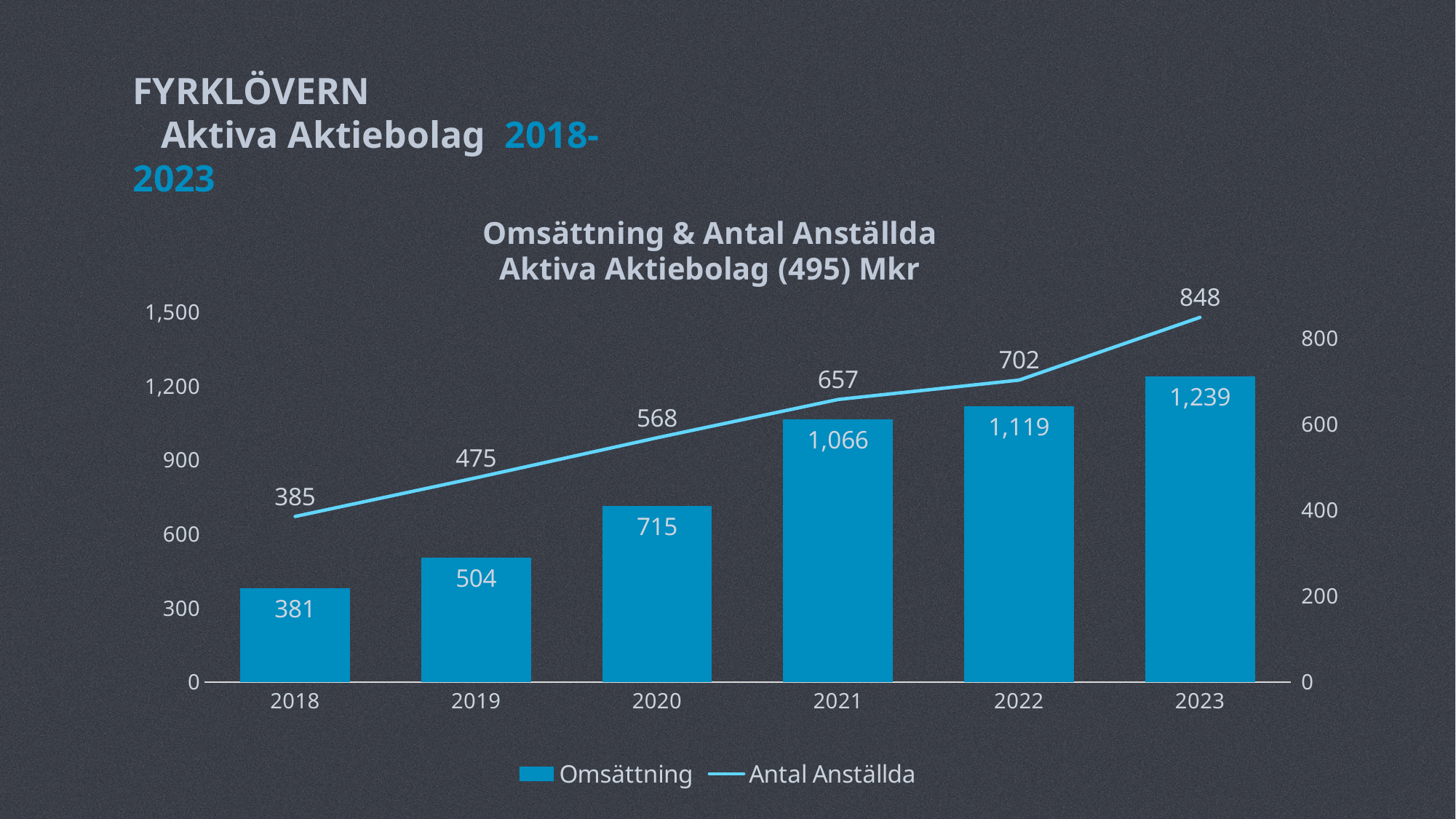
What is the difference in Omsättning between 2023 and 2022? 120 Does the Antal Anställda line rise or fall from 2018 to 2023? rise Which year has the lowest Antal Anställda? 2018 How many series does the legend list? 2 How many years are shown on the x axis? 6 What is the Omsättning value for 2018? 381 What is the Antal Anställda value for 2019? 475 Which year has the highest Omsättning? 2023 What is the Omsättning value for 2021? 1,066 Which is larger, the Omsättning for 2020 or for 2019? 2020 What is the difference in Antal Anställda between 2023 and 2018? 463 What is the title of the chart? Omsättning & Antal Anställda Aktiva Aktiebolag (495) Mkr